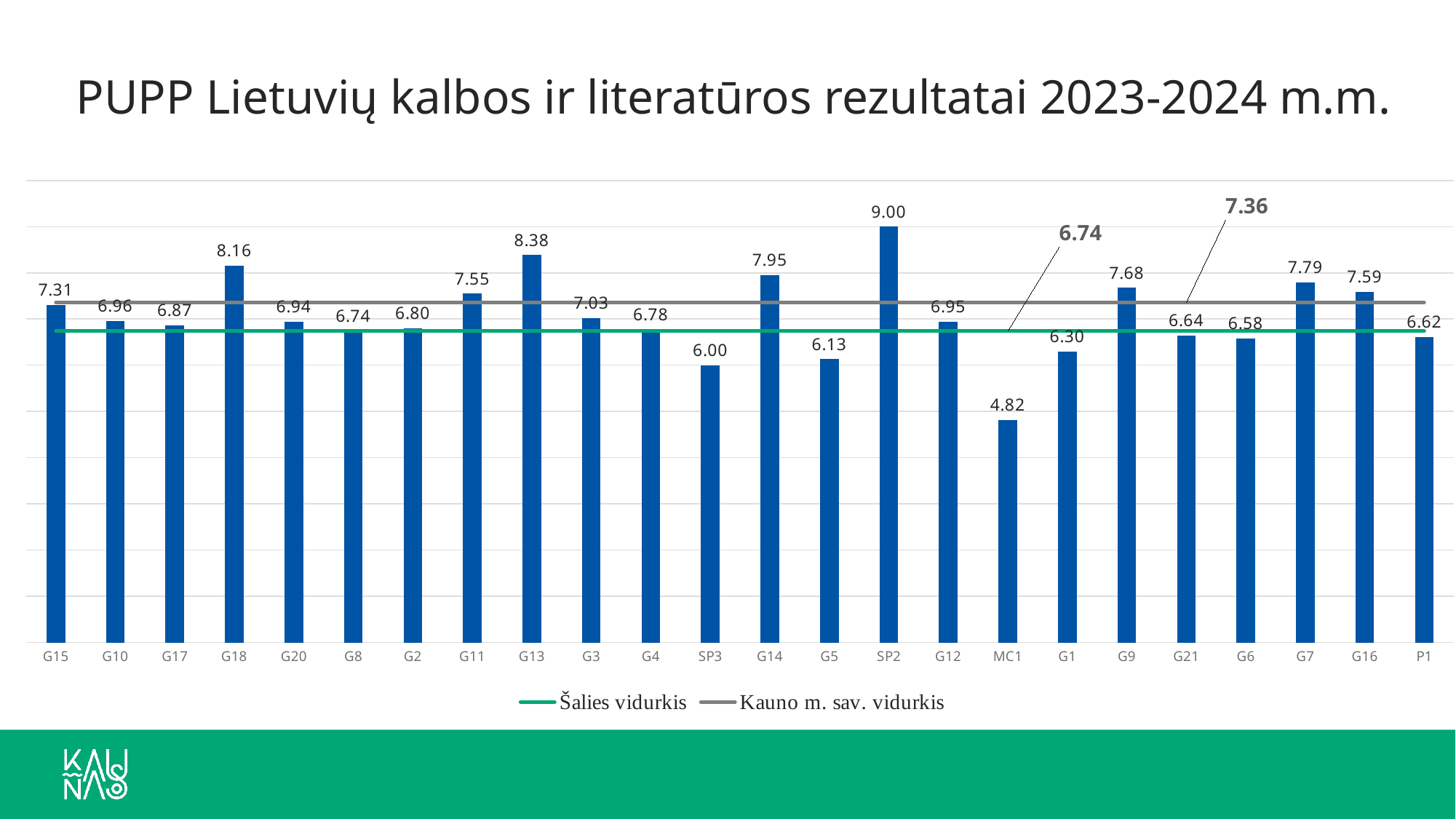
How many series does the legend list? 2 What is the difference between the values for SP2 and MC1? 4.18 What is the value for SP2? 9.00 How many categories are shown on the x axis? 24 Which category has the highest value? SP2 What value is labelled for the Šalies vidurkis line? 6.74 What is the value for MC1? 4.82 What kind of chart is this? bar chart What value is labelled for the Kauno m. sav. vidurkis line? 7.36 Which category has the lowest value? MC1 Which is larger, the value for G18 or the value for G14? G18 What is the value for G13? 8.38